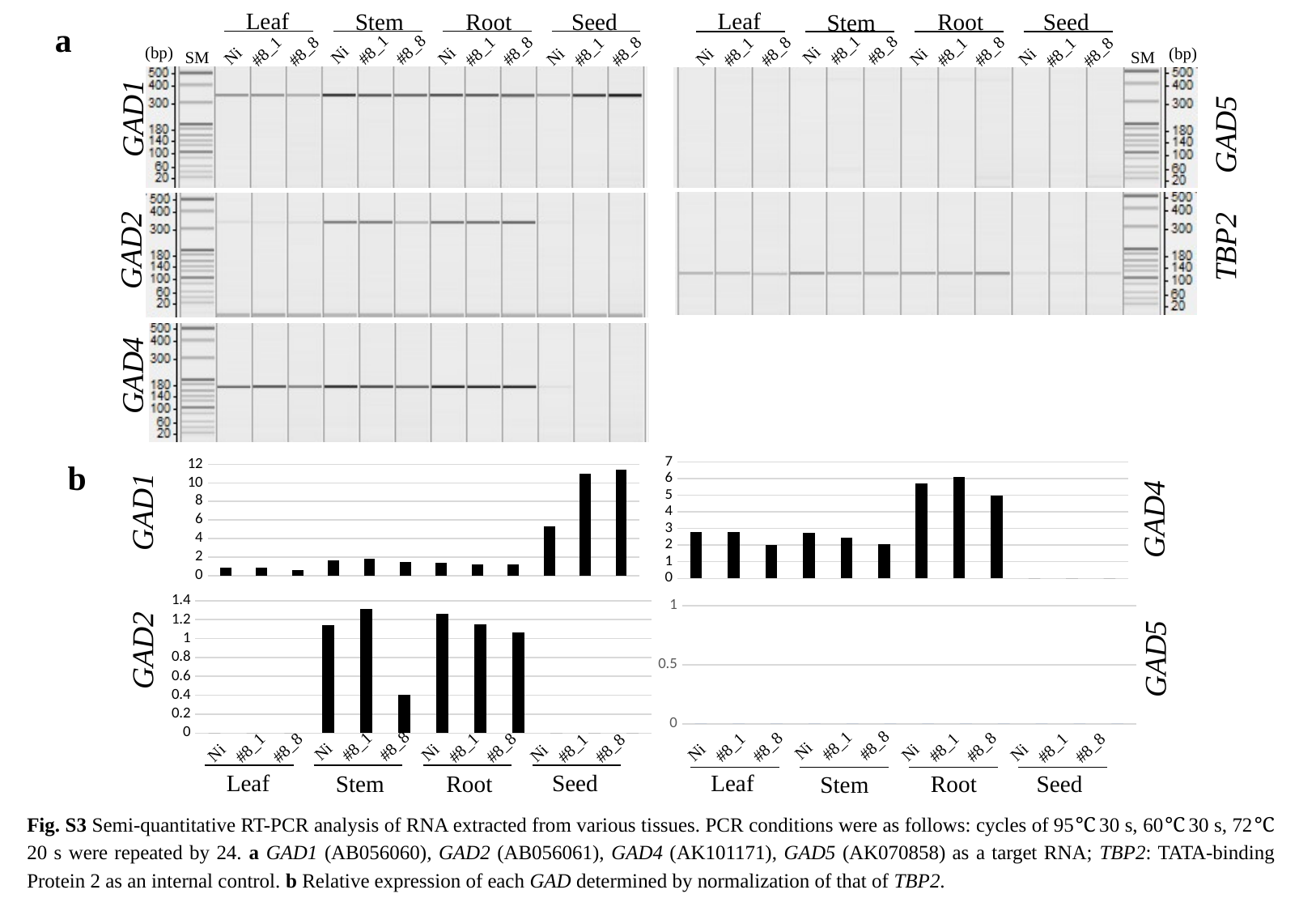
In the GAD1 chart in panel b, is the value for Seed Ni greater or less than 6? less In the GAD1 chart in panel b, which tissue has the highest relative expression? Seed In the GAD1 chart in panel b, which is larger, the value for Seed #8_1 or the value for Leaf Ni? Seed #8_1 In the GAD4 chart in panel b, which is larger, the value for Root Ni or the value for Stem Ni? Root Ni In the GAD4 chart in panel b, is the value for Root Ni greater or less than 5? greater In the GAD1 chart in panel b, how many bars (sample categories) are plotted along the x axis? 12 In the GAD2 chart in panel b, is the value for Stem #8_8 greater or less than 0.6? less In the GAD4 chart in panel b, which tissue shows no bars at all? Seed In the GAD2 chart in panel b, which tissues show no bars? Leaf and Seed What kind of chart is the GAD1 chart in panel b? bar chart In the GAD2 chart in panel b, which is larger, the value for Root Ni or the value for Stem #8_8? Root Ni